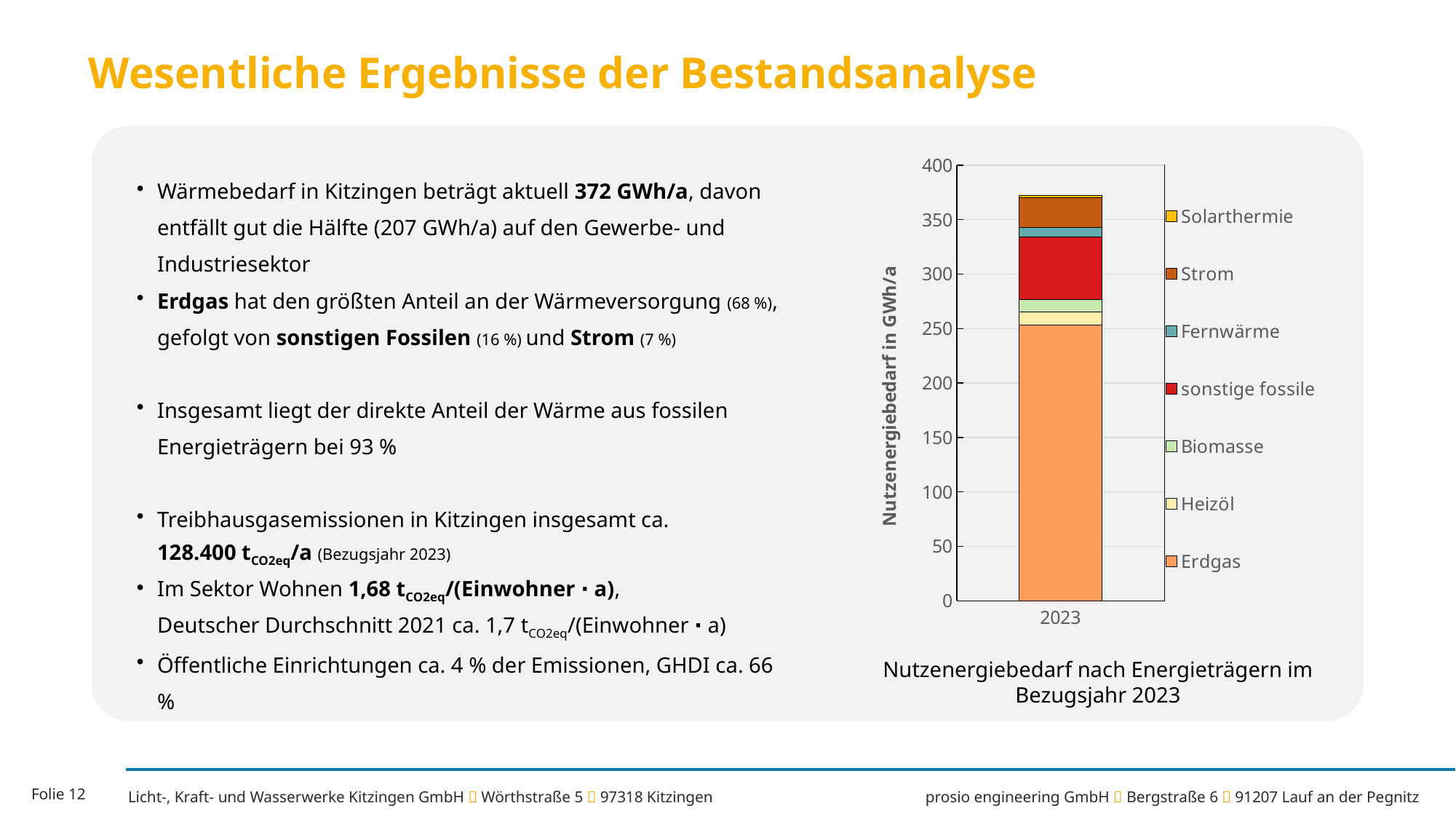
How many series does the chart legend list? 7 How many categories are shown on the x axis of the chart? 1 Which energy source has the smallest segment in the 2023 bar? Solarthermie What is the caption shown below the chart? Nutzenergiebedarf nach Energieträgern im Bezugsjahr 2023 What kind of chart is shown on the slide? stacked bar chart Is the total height of the 2023 bar greater or less than 400? less Is the total height of the 2023 bar greater or less than 350? greater What is the label of the y axis of the chart? Nutzenergiebedarf in GWh/a Which segment is larger in the 2023 bar, Strom or Fernwärme? Strom Which segment is larger in the 2023 bar, sonstige fossile or Strom? sonstige fossile Is the Erdgas segment of the 2023 bar greater or less than 200? greater Which energy source has the largest segment in the 2023 bar? Erdgas